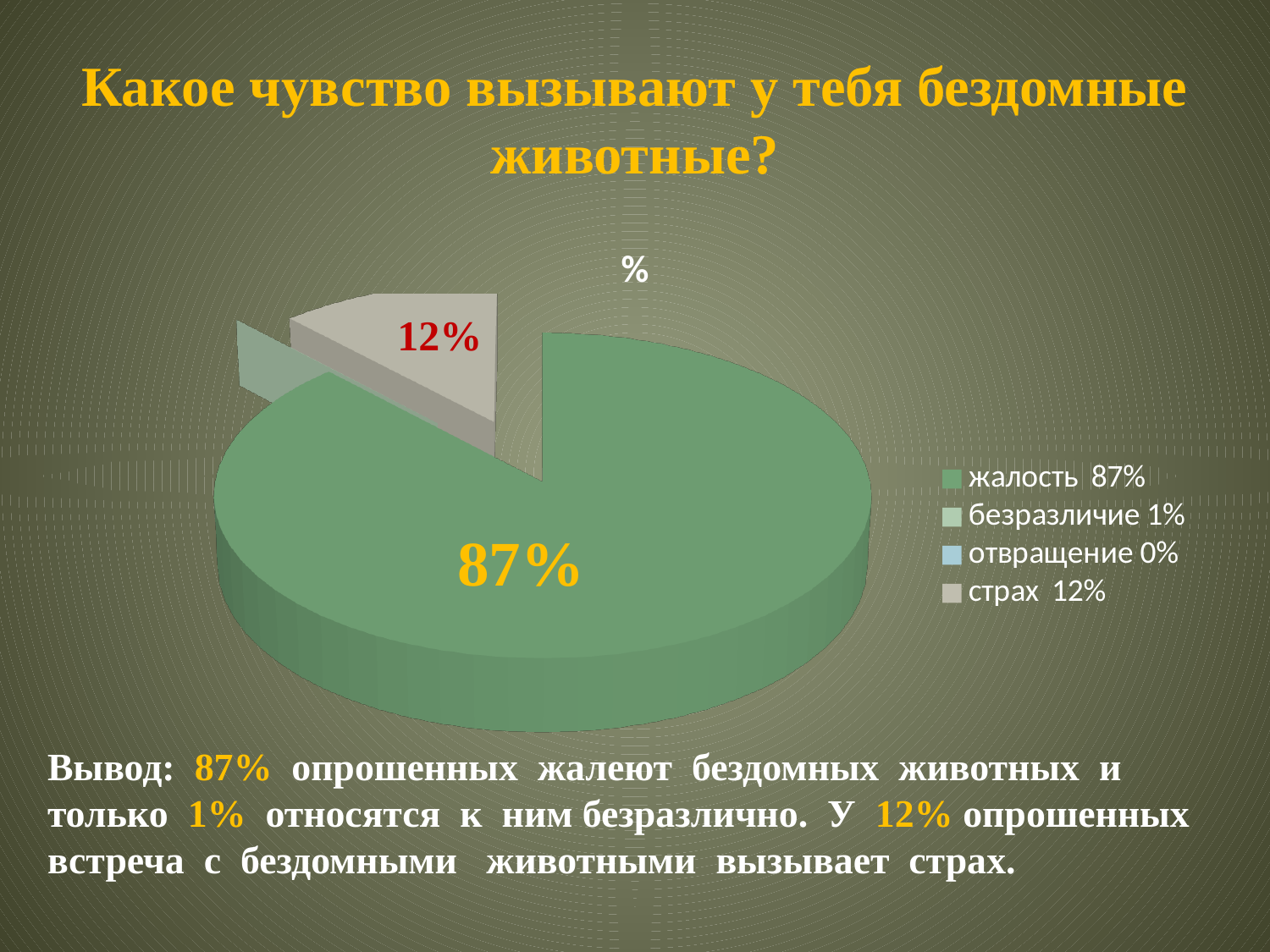
How many categories does the legend list? 4 What share of the pie does "страх" have? 12% Which category has the largest share of the pie? жалость What value does the legend give for "безразличие"? 1% Which is larger, the share for "страх" or the share for "безразличие"? страх What colour is the slice for "страх"? grey What kind of chart is shown on the slide? pie chart What share of the pie does "жалость" have? 87% What value does the legend give for "отвращение"? 0% What is the difference between the shares for "жалость" and "страх"? 75% What is the title shown above the pie chart? % Which category has the smallest value in the legend? отвращение